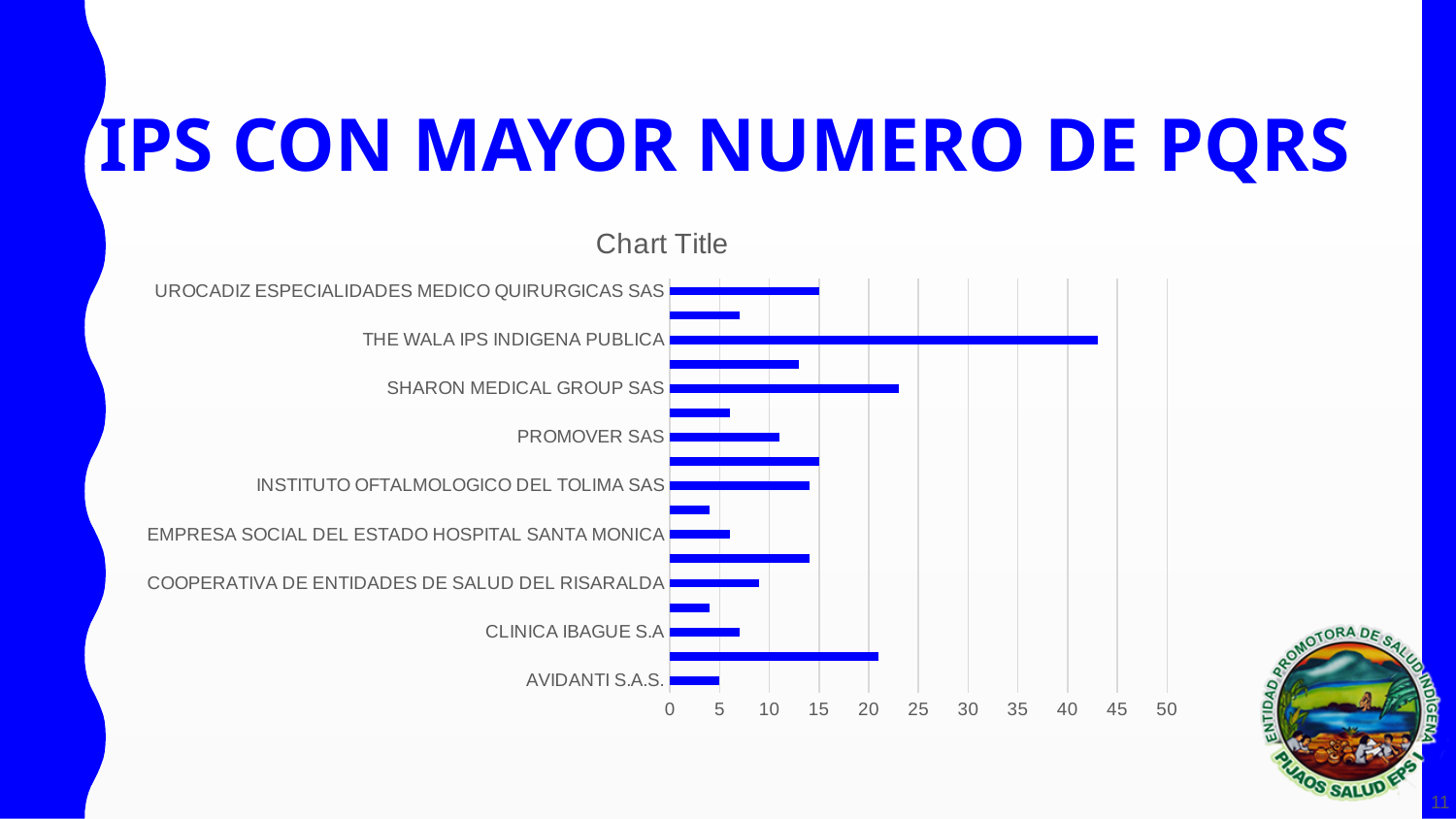
Which category has the highest value in the chart? THE WALA IPS INDIGENA PUBLICA What is the title printed above the chart? Chart Title How many category labels are shown on the vertical axis of the chart? 9 Which has a larger value, THE WALA IPS INDIGENA PUBLICA or SHARON MEDICAL GROUP SAS? THE WALA IPS INDIGENA PUBLICA Is the value for SHARON MEDICAL GROUP SAS greater or less than 20? greater What kind of chart is shown on the slide? bar chart Is the value for THE WALA IPS INDIGENA PUBLICA greater or less than 40? greater Is the value for UROCADIZ ESPECIALIDADES MEDICO QUIRURGICAS SAS greater or less than 10? greater Which has a larger value, UROCADIZ ESPECIALIDADES MEDICO QUIRURGICAS SAS or CLINICA IBAGUE S.A? UROCADIZ ESPECIALIDADES MEDICO QUIRURGICAS SAS